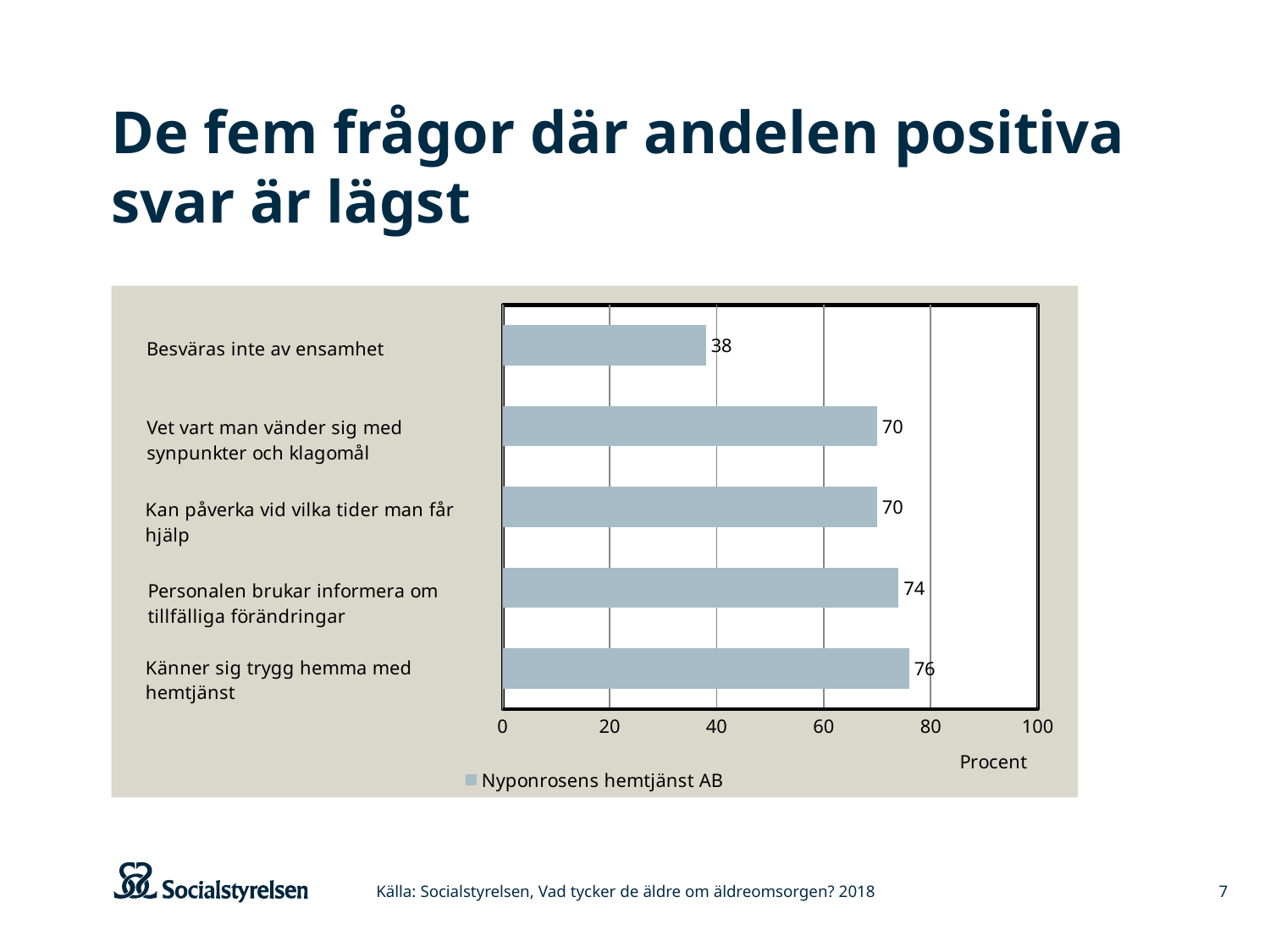
What is the value for "Personalen brukar informera om tillfälliga förändringar"? 74 How many series does the legend list? 1 Which is larger: the value for "Personalen brukar informera om tillfälliga förändringar" or the value for "Vet vart man vänder sig med synpunkter och klagomål"? Personalen brukar informera om tillfälliga förändringar What kind of chart is shown on the slide? bar chart Which category has the lowest value? Besväras inte av ensamhet How many categories are shown in the chart? 5 What is the value for "Besväras inte av ensamhet"? 38 Which category has the highest value? Känner sig trygg hemma med hemtjänst What is the difference between the values for "Känner sig trygg hemma med hemtjänst" and "Besväras inte av ensamhet"? 38 What is the value for "Kan påverka vid vilka tider man får hjälp"? 70 Is the value for "Besväras inte av ensamhet" greater or less than 40? less What is the value for "Känner sig trygg hemma med hemtjänst"? 76